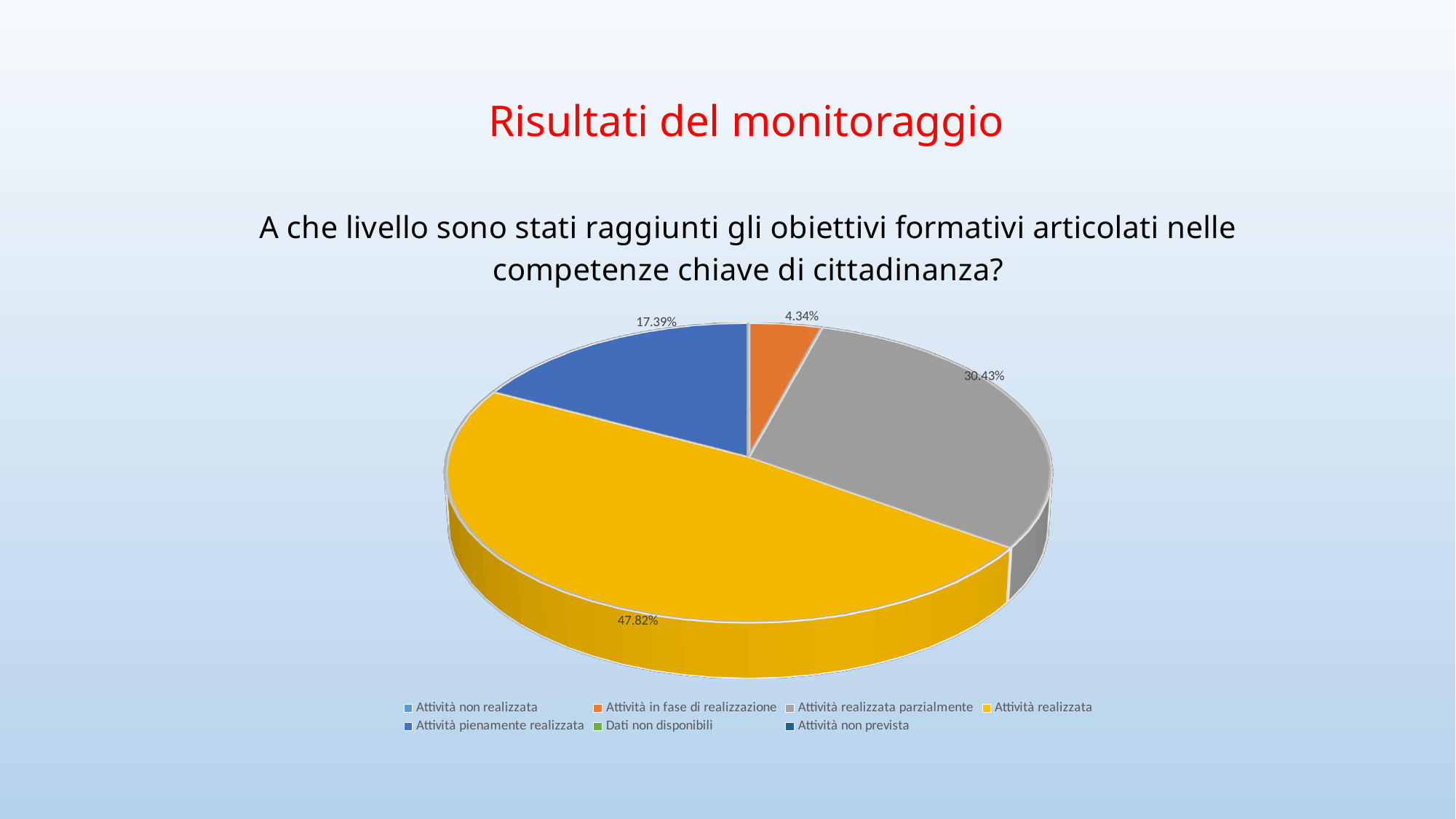
How many entries does the legend list? 7 What percentage is shown for "Attività realizzata"? 47.82% What is the title of the chart? A che livello sono stati raggiunti gli obiettivi formativi articolati nelle competenze chiave di cittadinanza? What kind of chart is shown on the slide? Pie chart What percentage is shown for "Attività pienamente realizzata"? 17.39% What percentage is shown for "Attività realizzata parzialmente"? 30.43% What colour is the slice for "Attività realizzata"? Yellow Which is larger: the slice for "Attività pienamente realizzata" or the slice for "Attività realizzata parzialmente"? Attività realizzata parzialmente What is the difference between the percentages for "Attività realizzata" and "Attività realizzata parzialmente"? 17.39% Which category has the largest slice of the pie? Attività realizzata What percentage is shown for "Attività in fase di realizzazione"? 4.34% Which category has the smallest slice of the pie? Attività in fase di realizzazione